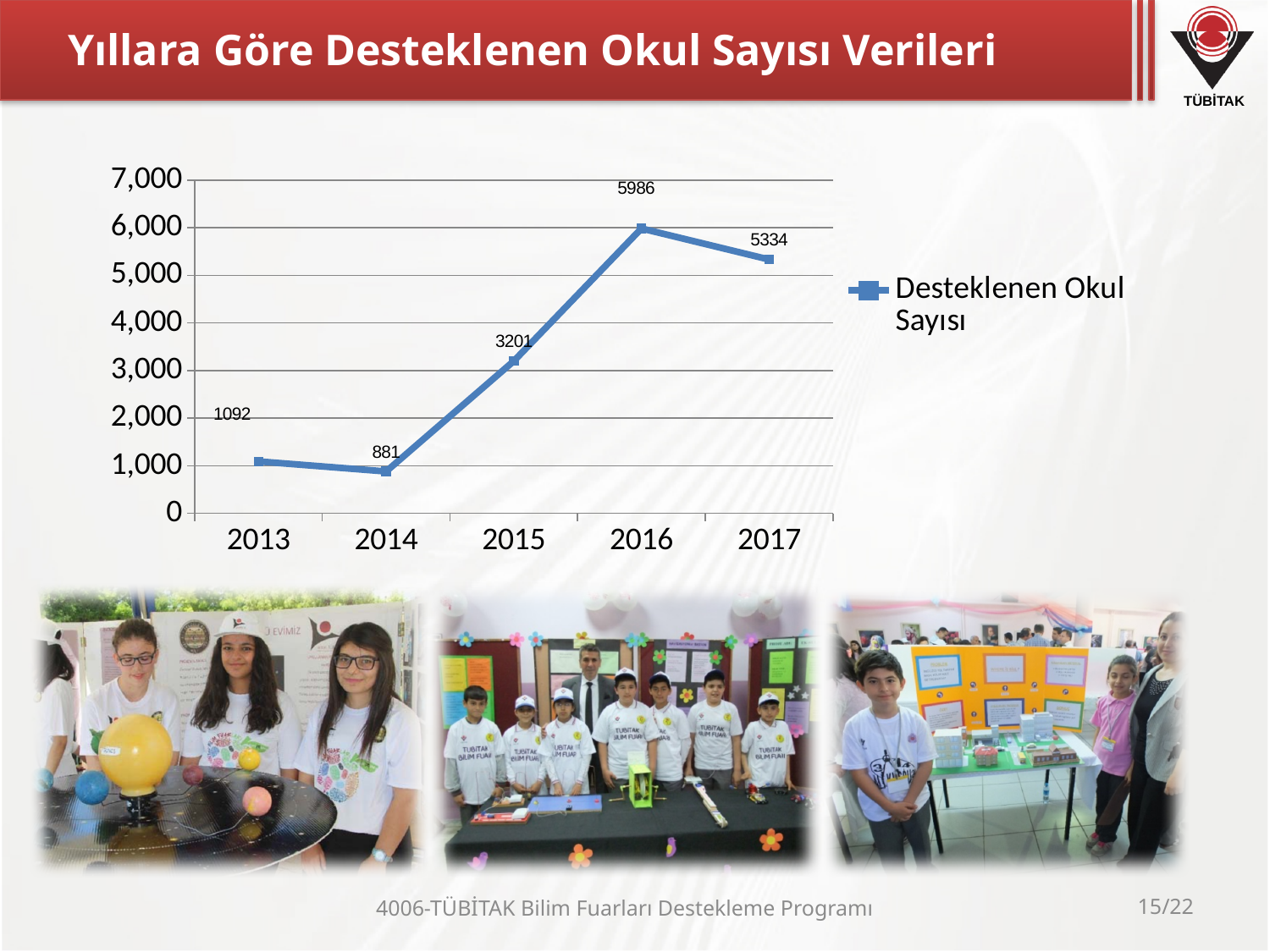
What is the value for 2016? 5986 How many years are shown on the x axis? 5 What is the value for 2017? 5334 What is the name of the series shown in the legend? Desteklenen Okul Sayısı What is the difference between the values for 2016 and 2017? 652 Which is larger, the value for 2013 or the value for 2014? 2013 Which year has the highest value? 2016 Which year has the lowest value? 2014 Is the value for 2015 greater or less than 3,000? greater What is the value for 2013? 1092 What kind of chart is this? line chart What is the difference between the values for 2015 and 2014? 2320